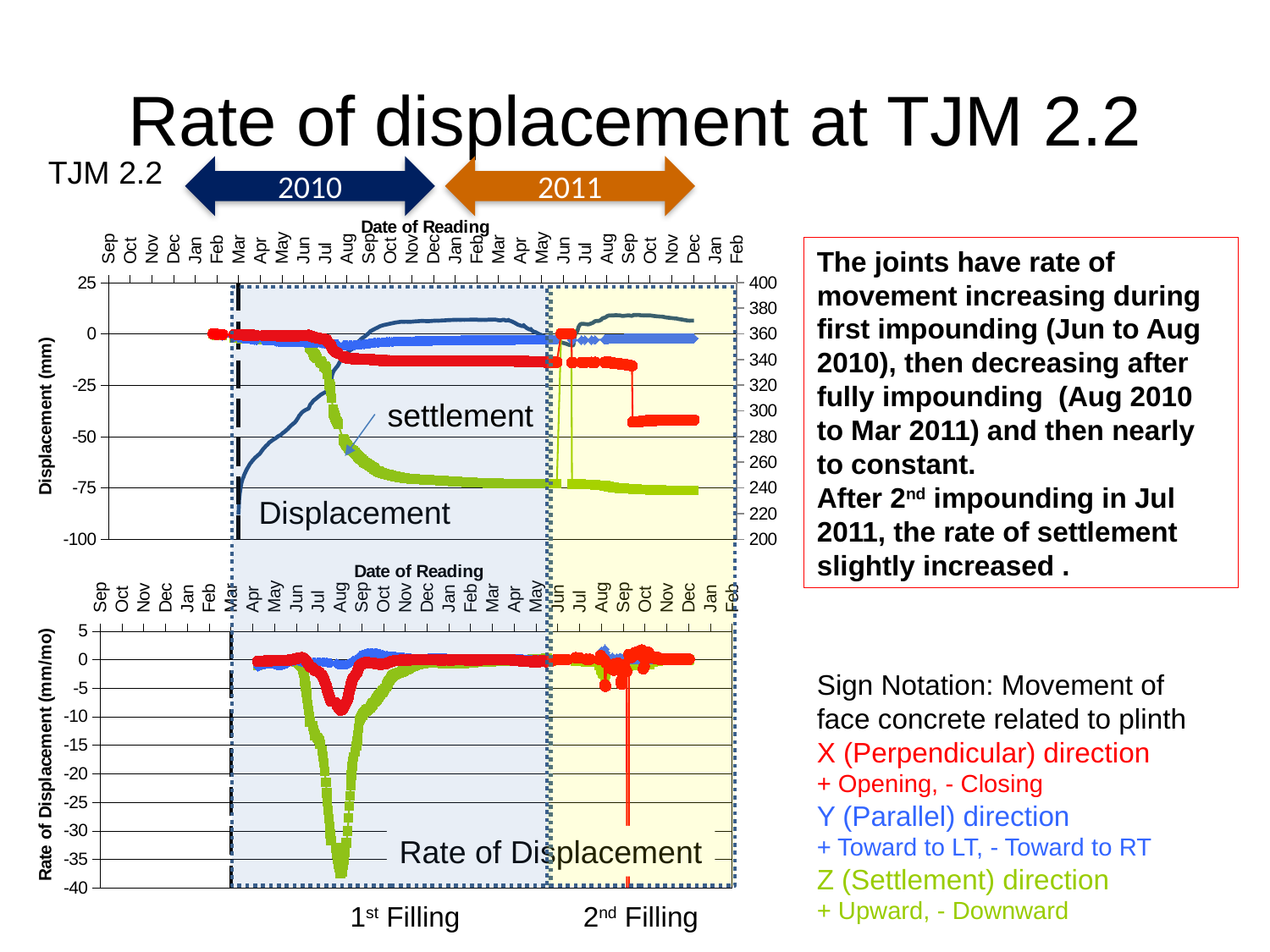
In the top 'Displacement' chart, is the value of the green (settlement) line in Dec 2011 greater or less than -50? less In the top 'Displacement' chart, is the value of the red line in Nov 2011 greater or less than -25? less In the top 'Displacement' chart, does the green (settlement) line rise or fall from Mar 2010 to Dec 2010? fall In the bottom 'Rate of Displacement' chart, which coloured line reaches the lowest rate during the 1st filling? green What is the y-axis label of the bottom chart? Rate of Displacement (mm/mo) In the bottom 'Rate of Displacement' chart, is the lowest value of the red line in Aug 2010 greater or less than -5? less According to the sign notation on the slide, which colour represents the Z (Settlement) direction? green In the bottom 'Rate of Displacement' chart, which line dips lower in Aug 2010, the red line or the blue line? red line In the top 'Displacement' chart, which line is lower in Dec 2011, the green line or the red line? green line What kind of chart is the top 'Displacement' chart? line chart